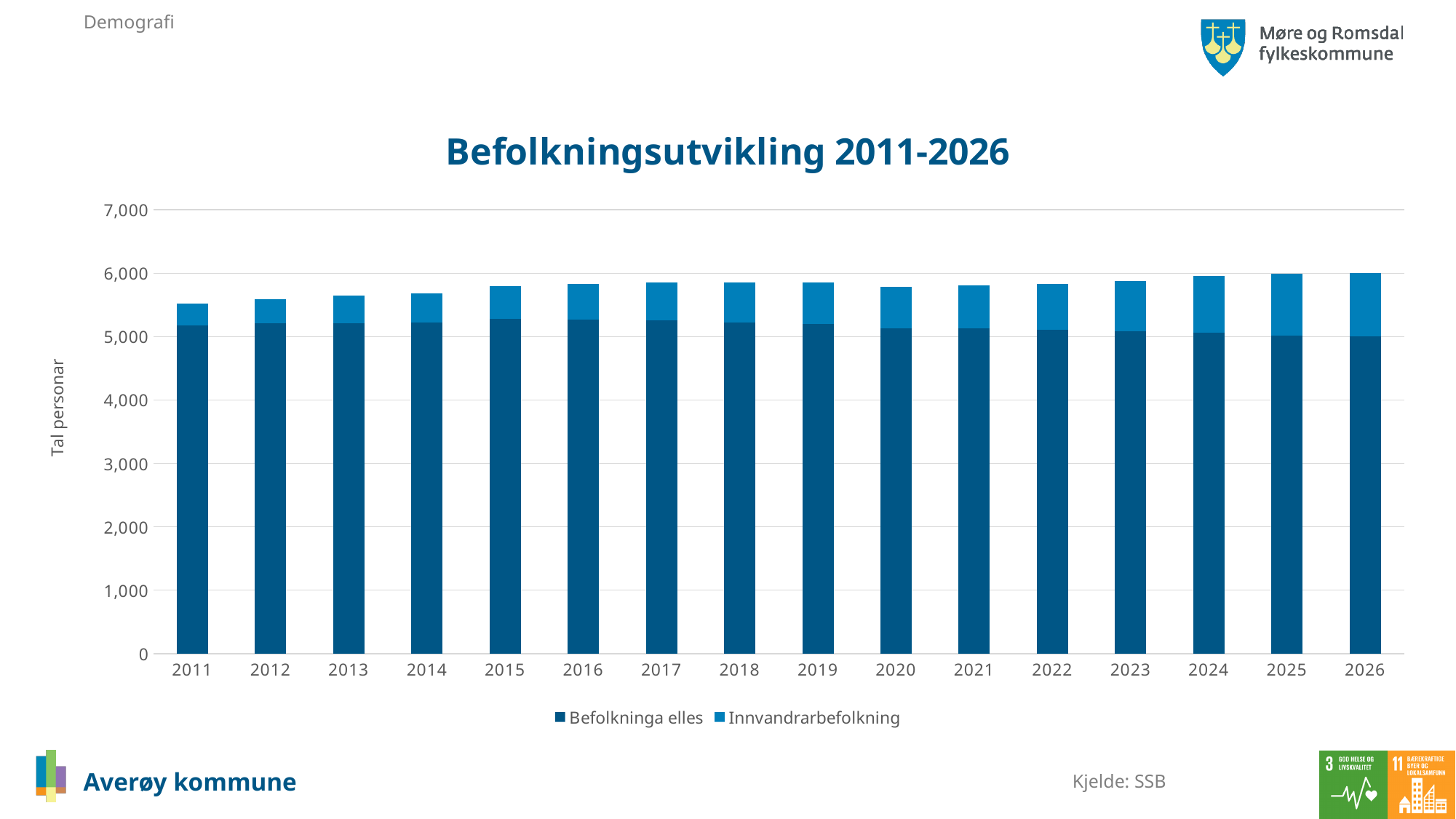
Which is larger, the Innvandrarbefolkning value in 2011 or in 2026? 2026 How many years are shown on the x axis? 16 What is the label of the vertical axis? Tal personar Which year has the lowest total bar? 2011 Is the total bar for 2011 greater or less than 5,000? greater How many series does the legend list? 2 Does the Befolkninga elles series rise or fall from 2015 to 2026? fall What kind of chart is shown on the slide? Stacked bar chart What is the title of the chart? Befolkningsutvikling 2011-2026 Is the total bar for 2011 greater or less than 6,000? less Is the value for Befolkninga elles in 2015 greater or less than 5,000? greater Which is larger, the total bar for 2011 or the total bar for 2024? 2024